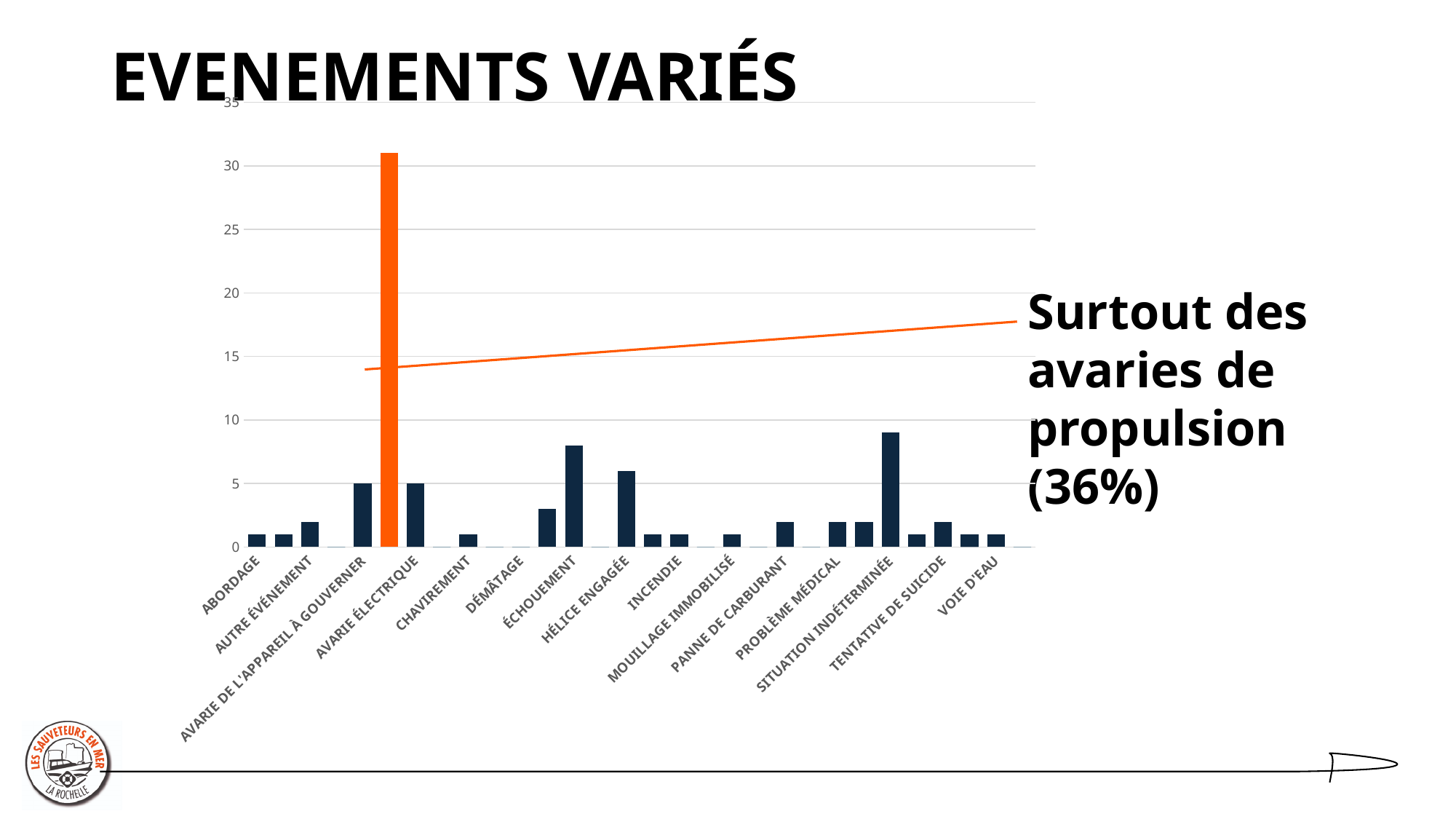
What is the value for AVARIE DE L'APPAREIL À GOUVERNER? 5 Is the value for ÉCHOUEMENT greater or less than 5? greater What is the title of the slide containing the chart? EVENEMENTS VARIÉS Is the value of the orange bar greater or less than 30? greater What colour is the tallest bar in the chart? orange Which is larger, the value for SITUATION INDÉTERMINÉE or the value for VOIE D'EAU? SITUATION INDÉTERMINÉE What kind of chart is shown on the slide? bar chart Is the value for HÉLICE ENGAGÉE greater or less than 5? greater What is the difference between the values for AVARIE DE L'APPAREIL À GOUVERNER and AVARIE ÉLECTRIQUE? 0 Which is larger, the value for ÉCHOUEMENT or the value for HÉLICE ENGAGÉE? ÉCHOUEMENT What is the value for AVARIE ÉLECTRIQUE? 5